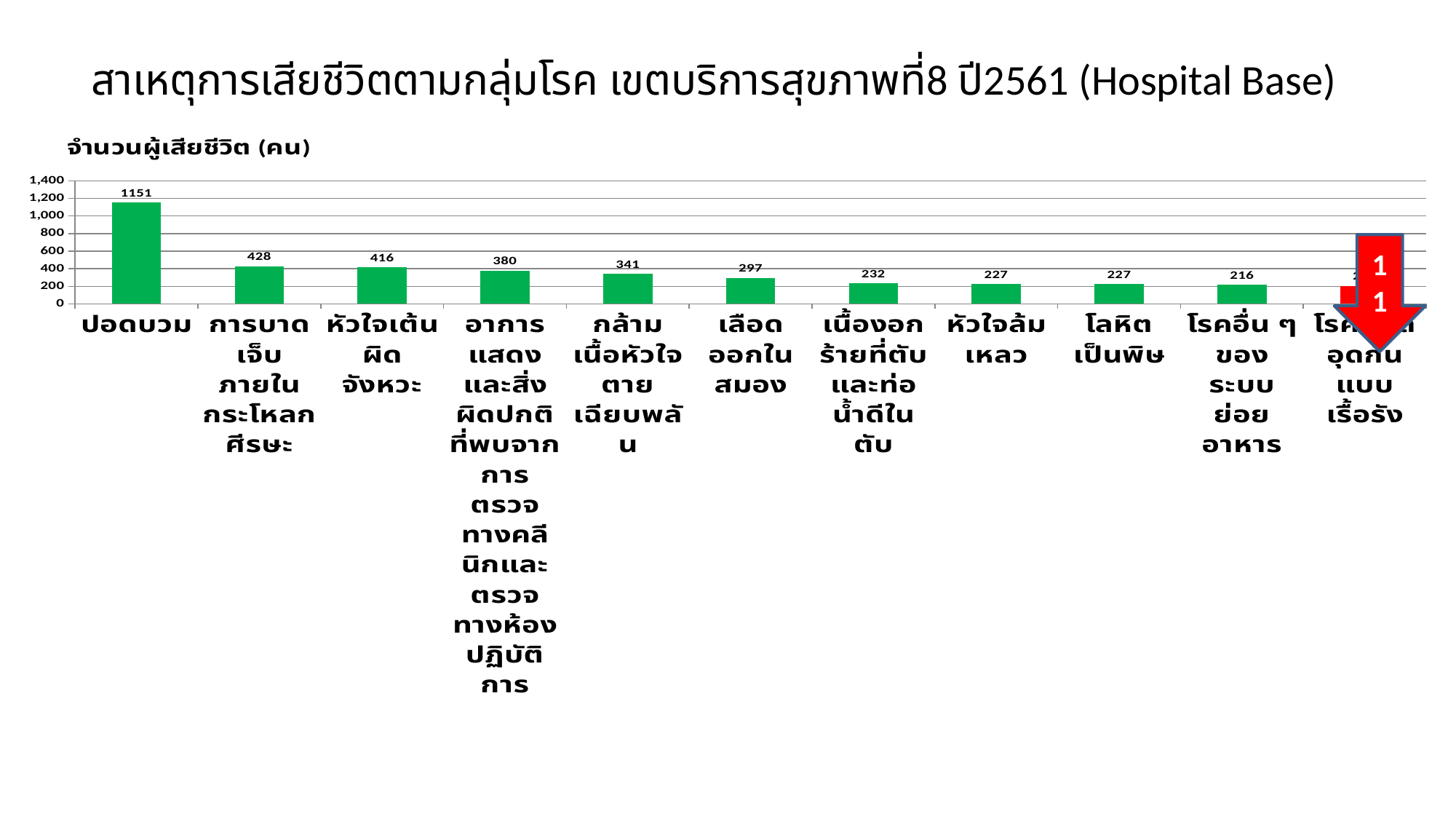
What is the label of the vertical axis of the chart? จำนวนผู้เสียชีวิต (คน) What is the number of deaths for หัวใจเต้นผิดจังหวะ? 416 What is the number of deaths for ปอดบวม? 1151 What is the number of deaths for โลหิตเป็นพิษ? 227 What is the number of deaths for การบาดเจ็บภายในกระโหลกศีรษะ? 428 Which cause of death has the highest number of deaths? ปอดบวม Is the value for ปอดบวม greater or less than 1,000? greater How many categories (causes of death) are shown in the chart? 11 Which has more deaths, กล้ามเนื้อหัวใจตายเฉียบพลัน or เนื้องอกร้ายที่ตับและท่อน้ำดีในตับ? กล้ามเนื้อหัวใจตายเฉียบพลัน What type of chart is shown on the slide? bar chart What is the difference in deaths between ปอดบวม and การบาดเจ็บภายในกระโหลกศีรษะ? 723 What is the number of deaths for เลือดออกในสมอง? 297